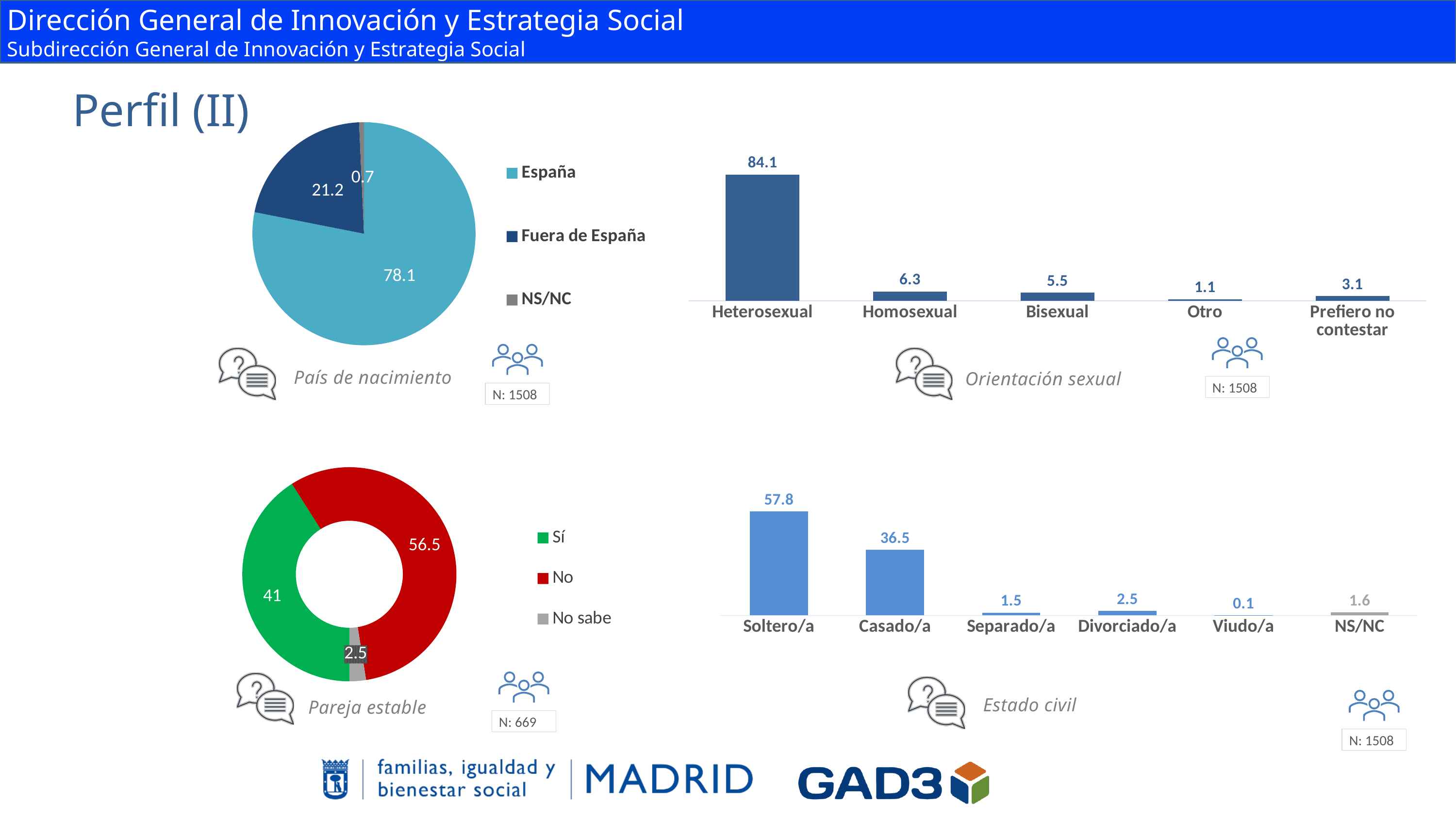
In the 'Estado civil' bar chart, what is the difference between Soltero/a and Casado/a? 21.3 In the 'País de nacimiento' pie chart, what is the value for Fuera de España? 21.2 How many categories does the 'Estado civil' bar chart show? 6 In the 'Orientación sexual' bar chart, what is the difference between Homosexual and Bisexual? 0.8 In the 'Estado civil' bar chart, what is the value for Casado/a? 36.5 What type of chart is the 'Orientación sexual' chart? Bar chart In the 'Pareja estable' doughnut chart, what is the value for Sí? 41 In the 'Pareja estable' doughnut chart, which is larger, Sí or No? No In the 'País de nacimiento' pie chart, what is the value for España? 78.1 In the 'Orientación sexual' bar chart, what is the value for Bisexual? 5.5 In the 'Orientación sexual' bar chart, which category has the lowest value? Otro In the 'Orientación sexual' bar chart, which category has the highest value? Heterosexual